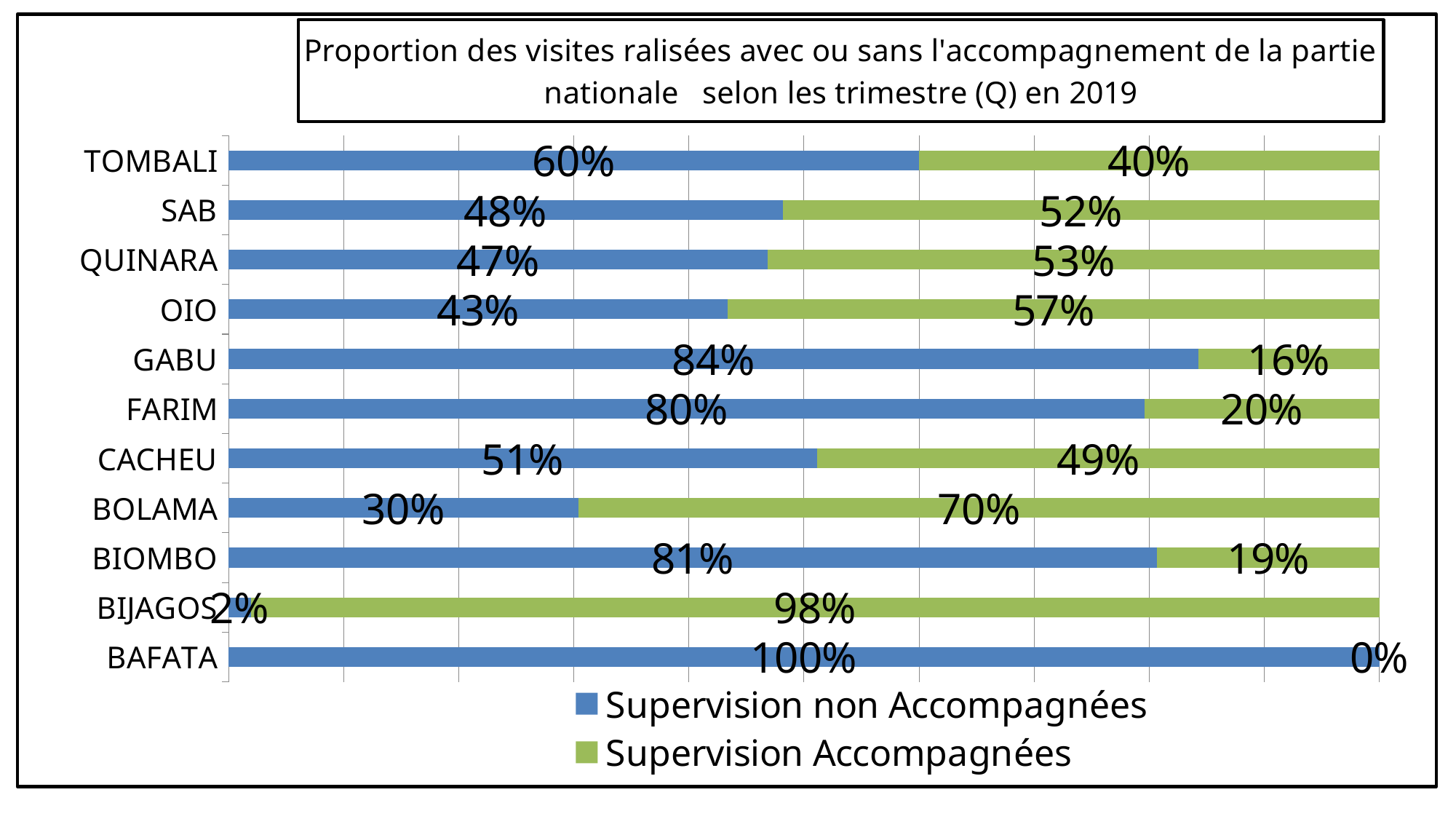
What is the value of Supervision Accompagnées for BOLAMA? 70% Which region has the lowest value for Supervision Accompagnées? BAFATA Which is larger: Supervision Accompagnées for QUINARA or for SAB? QUINARA Which region has the highest value for Supervision non Accompagnées? BAFATA What is the value of Supervision non Accompagnées for TOMBALI? 60% How many series does the legend list? 2 What colour represents Supervision Accompagnées in the chart? Green How many regions are shown on the chart? 11 What kind of chart is shown on the slide? Stacked bar chart What is the value of Supervision Accompagnées for BIJAGOS? 98% What is the value of Supervision non Accompagnées for GABU? 84% What is the difference between the Supervision non Accompagnées values for FARIM and OIO? 37%